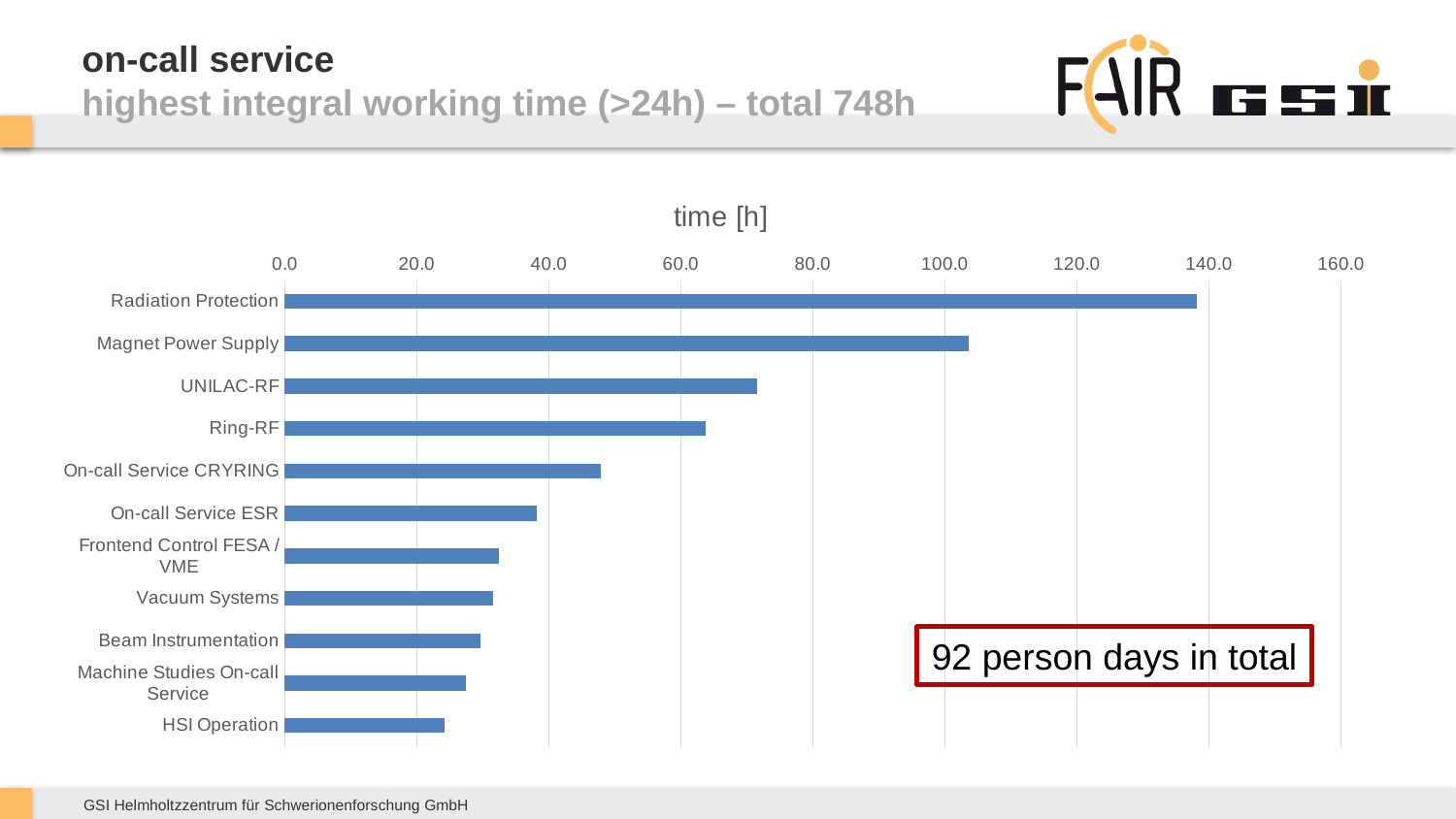
Which category has the highest time [h] value? Radiation Protection Which has a larger value, Ring-RF or On-call Service ESR? Ring-RF Is the value for HSI Operation greater or less than 40.0? less Is the value for Magnet Power Supply greater or less than 100.0? greater Is the value for On-call Service CRYRING greater or less than 40.0? greater Which has a larger value, Magnet Power Supply or UNILAC-RF? Magnet Power Supply Which category has the lowest time [h] value? HSI Operation How many categories are plotted in the chart? 11 What kind of chart is shown on the slide? bar chart What is the title of the chart? time [h]